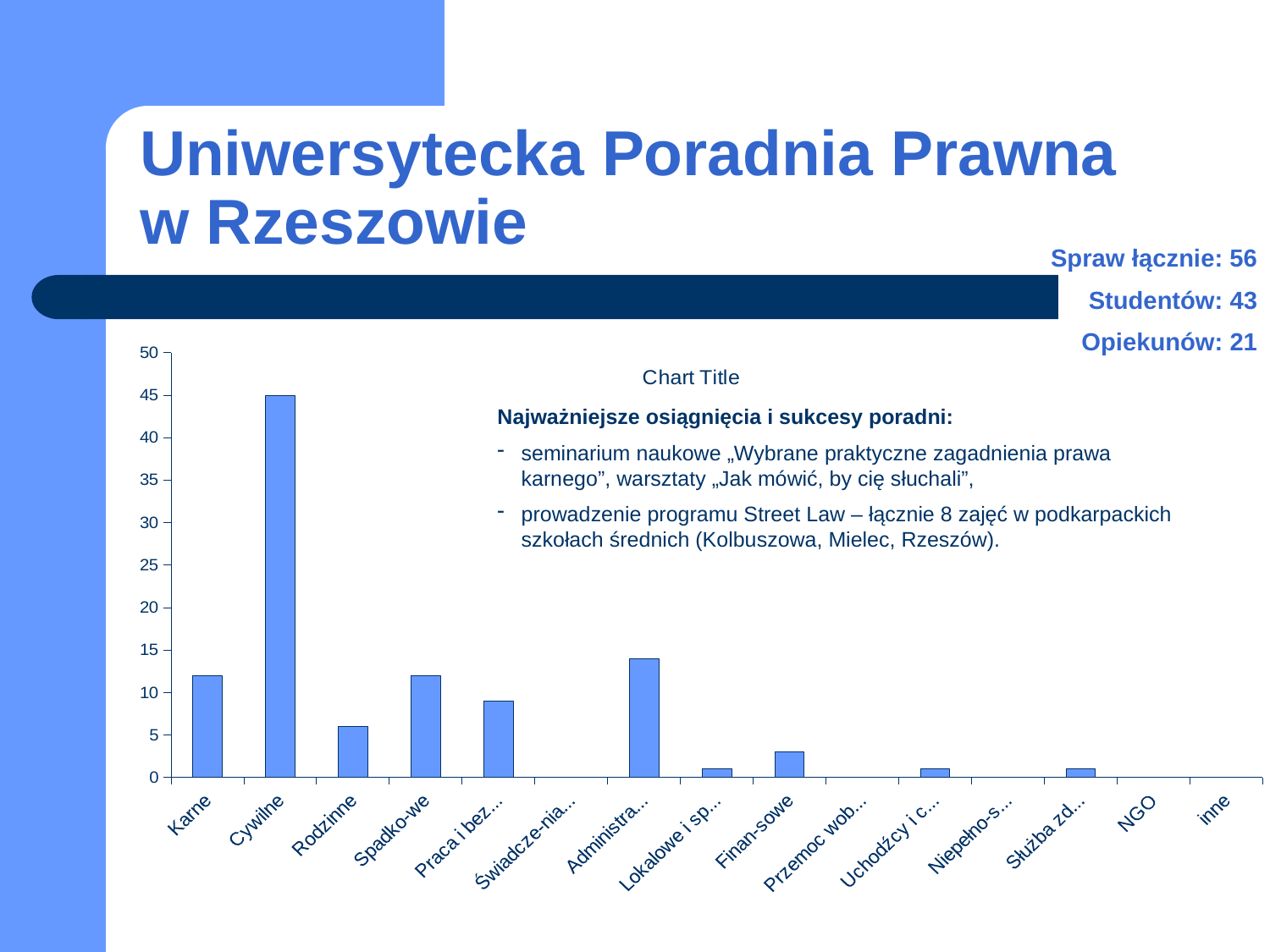
Is the value for Administra... greater or less than 10? greater Is the value for Finansowe greater or less than 5? less Which is larger, the value for Karne or the value for Rodzinne? Karne How many categories are shown on the x axis of the chart? 15 Which is larger, the value for Cywilne or the value for Karne? Cywilne Is the value for Karne greater or less than 10? greater What is the title shown on the chart? Chart Title What kind of chart is shown on the slide? bar chart Which category has the highest bar in the chart? Cywilne What is the value for Cywilne in the chart? 45